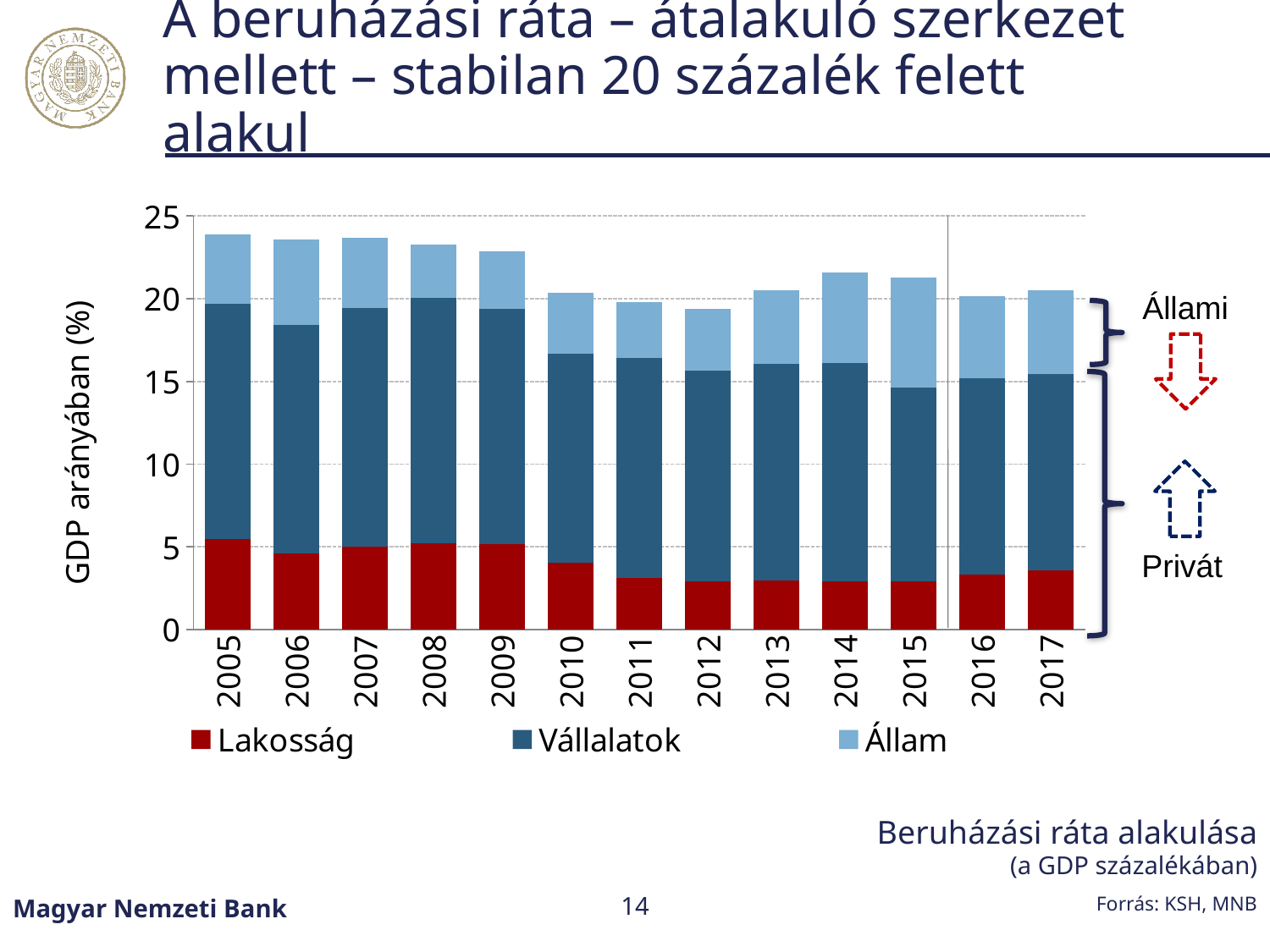
What kind of chart is shown on the slide? stacked bar chart Does the Lakosság value rise or fall from 2005 to 2012? fall How many years are shown on the x axis of the chart? 13 What is the label of the vertical axis of the chart? GDP arányában (%) Is the total stacked value for 2005 greater or less than 20? greater Which year has the larger Lakosság value, 2005 or 2017? 2005 How many series does the chart's legend list? 3 Which year has the larger total stacked value, 2005 or 2012? 2005 Which series are listed in the chart's legend? Lakosság, Vállalatok, Állam Is the Lakosság value for 2011 greater or less than 5? less Is the Lakosság value for 2005 greater or less than 5? greater